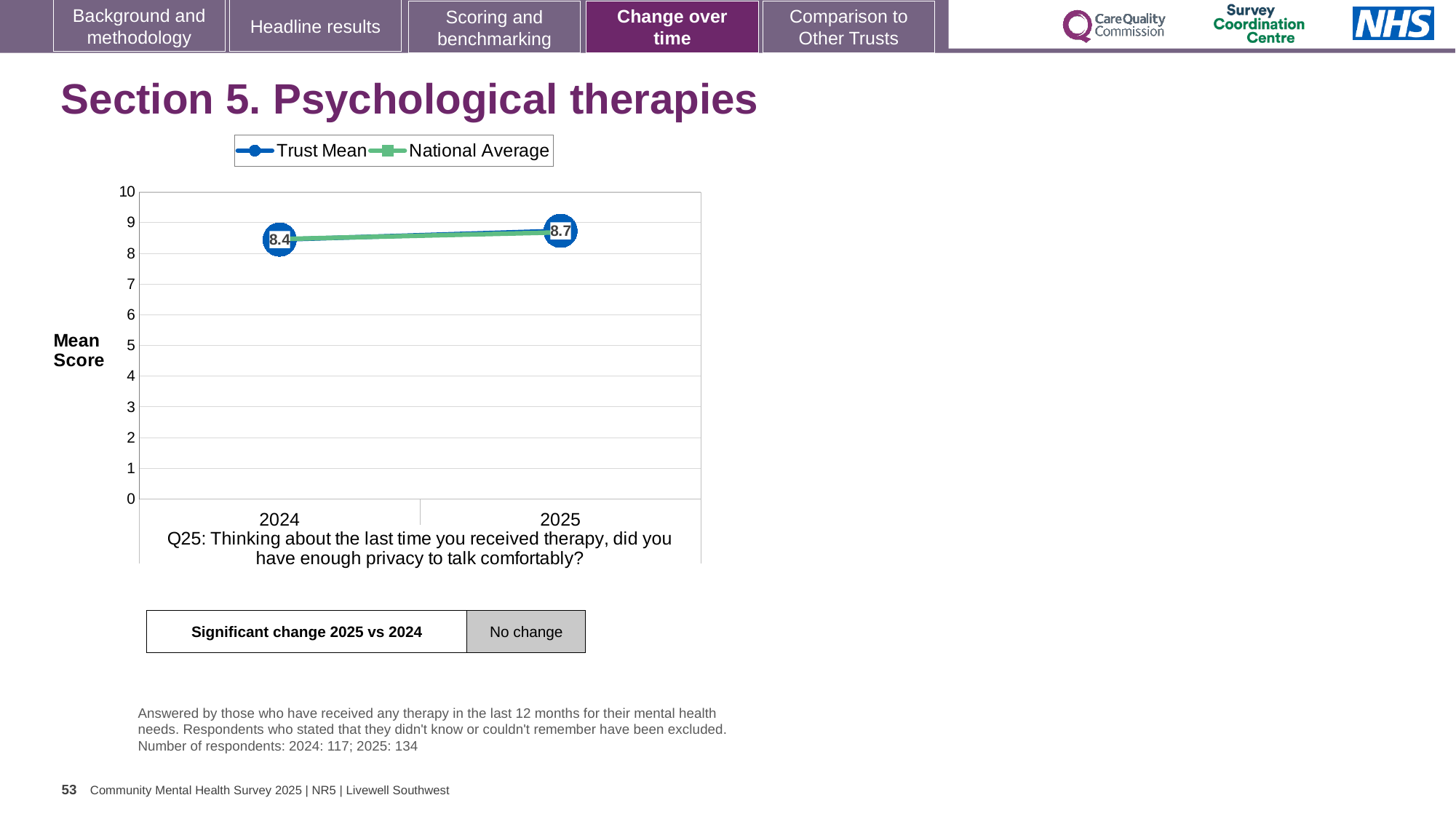
How many years are shown on the x axis of the chart? 2 Is the National Average value for 2025 greater or less than 9? less Does the Trust Mean score rise or fall from 2024 to 2025? Rise In which year is the Trust Mean score lowest? 2024 In which year is the Trust Mean score highest? 2025 What is the Trust Mean score for 2025? 8.7 What is the Trust Mean score for 2024? 8.4 How many series does the chart legend list? 2 Which is larger, the Trust Mean score for 2024 or for 2025? 2025 What is the difference between the Trust Mean scores for 2025 and 2024? 0.3 Is the National Average value for 2024 greater or less than 8? greater What kind of chart is shown on the slide? Line chart